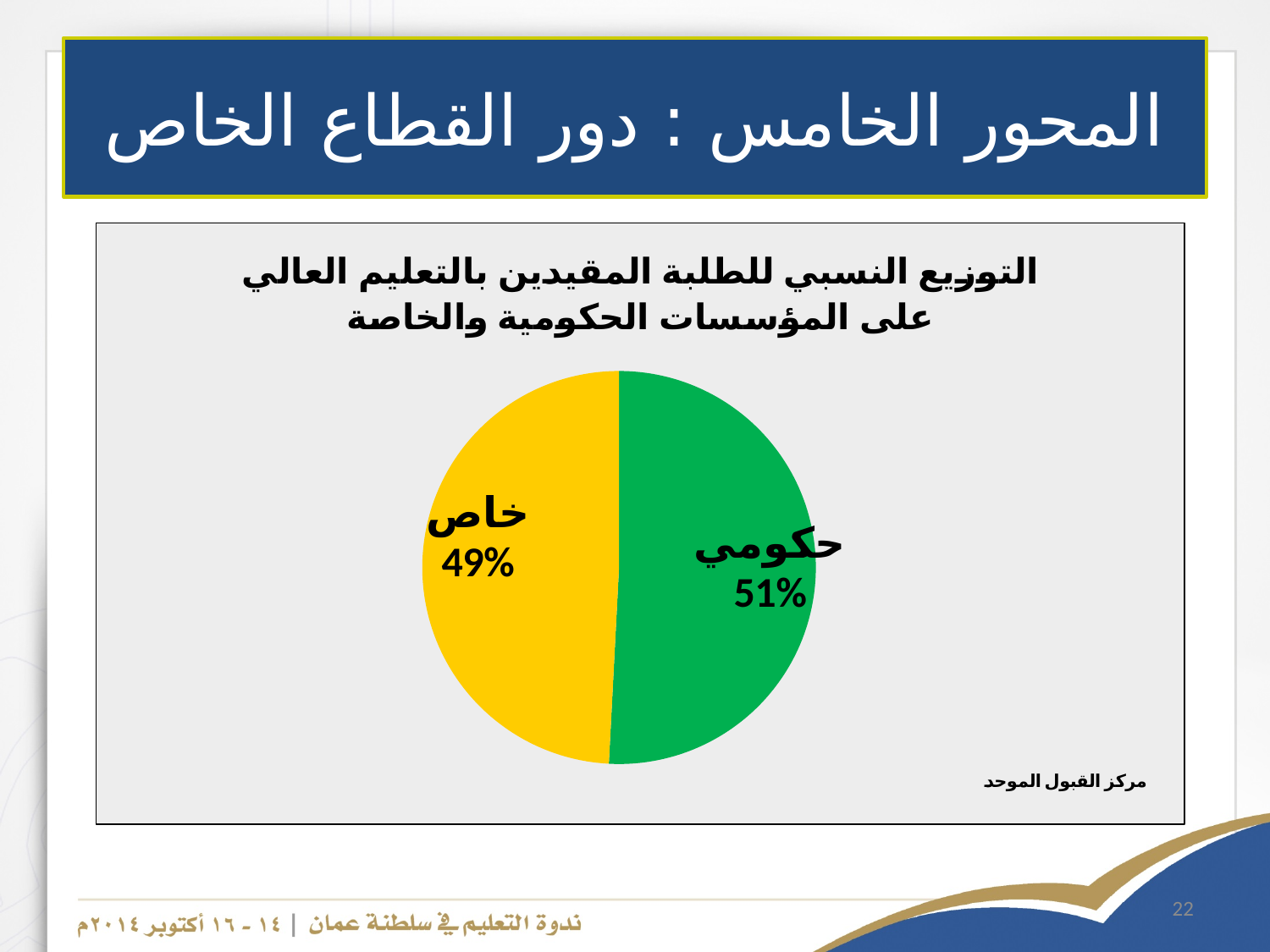
What is the difference between the حكومي and خاص percentages? 2% Which is larger, the share for حكومي or the share for خاص? حكومي What type of chart is shown on the slide? pie chart What share of the pie does the حكومي slice represent? 51% What colour is the حكومي slice? green What source is cited at the bottom of the chart? مركز القبول الموحد What is the value shown for حكومي? 51% Which category has the largest slice of the pie? حكومي How many slices does the pie chart have? 2 What share of the pie does the خاص slice represent? 49% Which category has the smallest slice of the pie? خاص What is the value shown for خاص? 49%